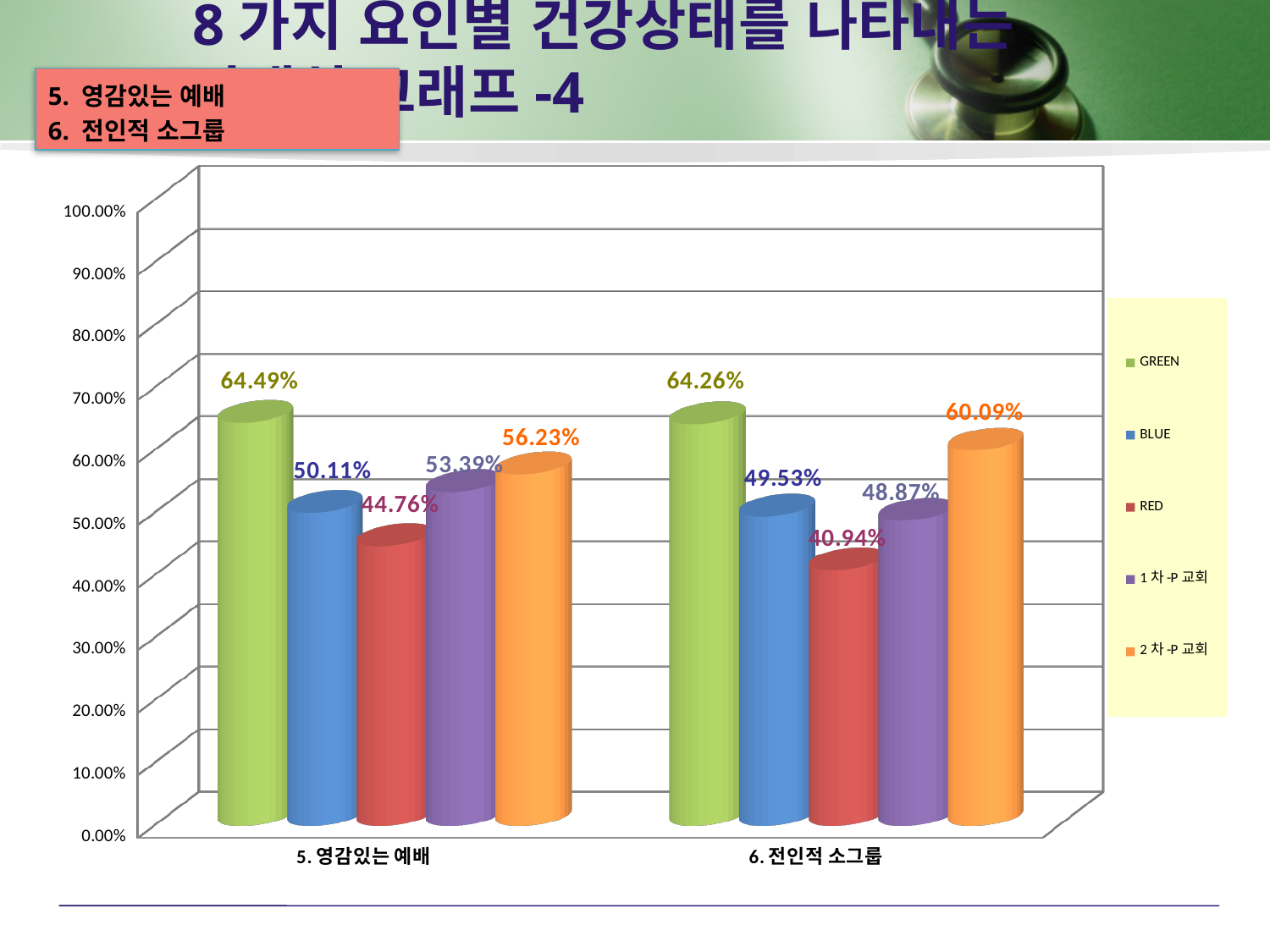
Which series has the lowest value in the category "5. 영감있는 예배"? RED What kind of chart is shown on the slide? Bar chart What is the value for 2차-P 교회 in the category "6. 전인적 소그룹"? 60.09% What colour represents the RED series in the chart? Red How many categories are shown on the x axis? 2 Which is larger: the 2차-P 교회 value for "5. 영감있는 예배" or the 2차-P 교회 value for "6. 전인적 소그룹"? 6. 전인적 소그룹 What is the difference between the GREEN value and the BLUE value in the category "5. 영감있는 예배"? 14.38% How many series does the legend list? 5 What is the value for RED in the category "6. 전인적 소그룹"? 40.94% What is the value for GREEN in the category "5. 영감있는 예배"? 64.49% What is the value for 1차-P 교회 in the category "5. 영감있는 예배"? 53.39% Which series has the highest value in the category "6. 전인적 소그룹"? GREEN